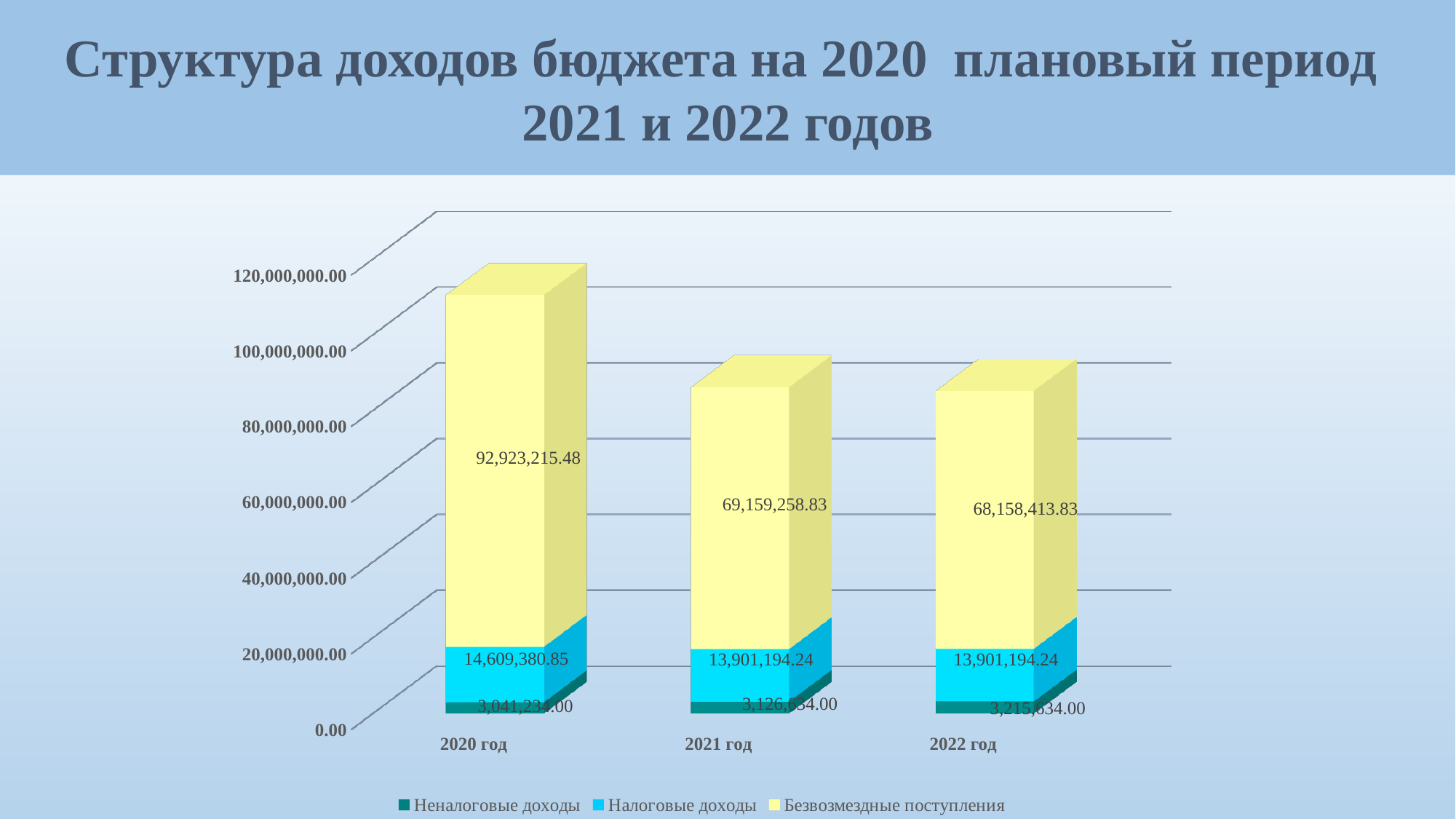
How many series does the legend list? 3 Which year has the highest value for Безвозмездные поступления? 2020 год What is the total of the stacked bar for 2021 год? 86,187,087.07 Which year has the lowest value for Неналоговые доходы? 2020 год How many categories (years) are shown on the x axis? 3 What is the difference between Безвозмездные поступления in 2020 год and 2021 год? 23,763,956.65 What type of chart is shown on the slide? stacked bar chart Do the values of Безвозмездные поступления rise or fall from 2020 год to 2022 год? fall What is the value of Налоговые доходы for 2021 год? 13,901,194.24 What is the value of Безвозмездные поступления for 2020 год? 92,923,215.48 Is the value of Налоговые доходы larger in 2020 год or in 2021 год? 2020 год What is the value of Неналоговые доходы for 2022 год? 3,215,634.00